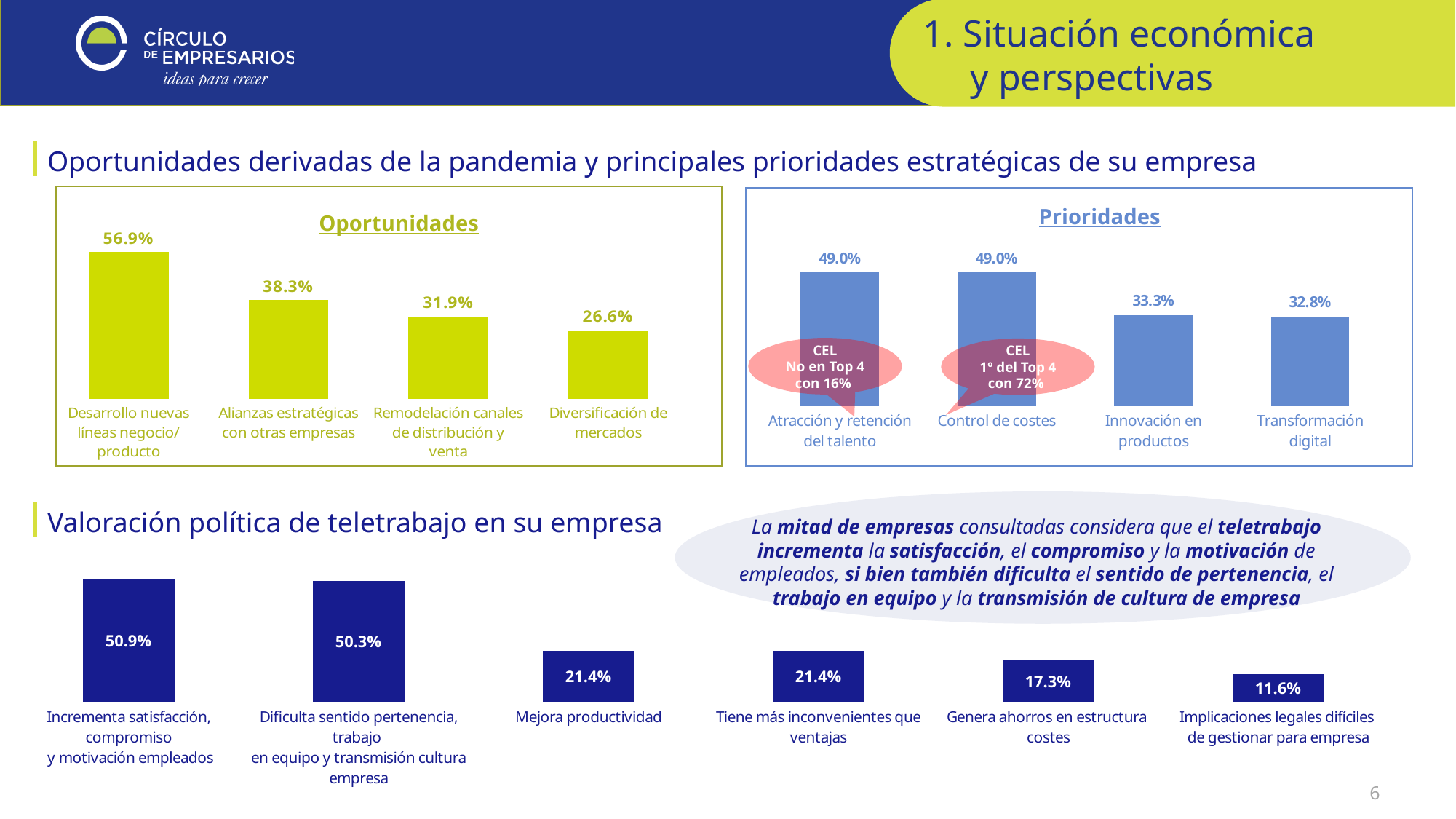
In the "Oportunidades" chart, what is the value for "Desarrollo nuevas líneas negocio/producto"? 56.9% In the bottom chart on teletrabajo, which category has the highest value? Incrementa satisfacción, compromiso y motivación empleados In the "Prioridades" chart, what is the difference between "Control de costes" and "Transformación digital"? 16.2% In the "Oportunidades" chart, what is the difference between "Desarrollo nuevas líneas negocio/producto" and "Alianzas estratégicas con otras empresas"? 18.6% In the "Oportunidades" chart, how many categories are shown? 4 In the bottom chart on teletrabajo, what is the value for "Genera ahorros en estructura costes"? 17.3% In the "Prioridades" chart, which category has the lowest value? Transformación digital In the "Prioridades" chart, what is the value for "Innovación en productos"? 33.3% In the bottom chart on teletrabajo, which is larger: "Mejora productividad" or "Implicaciones legales difíciles de gestionar para empresa"? Mejora productividad In the "Prioridades" chart, what kind of chart is used? Bar chart In the bottom chart on teletrabajo, how many categories are shown? 6 In the "Oportunidades" chart, which category has the lowest value? Diversificación de mercados